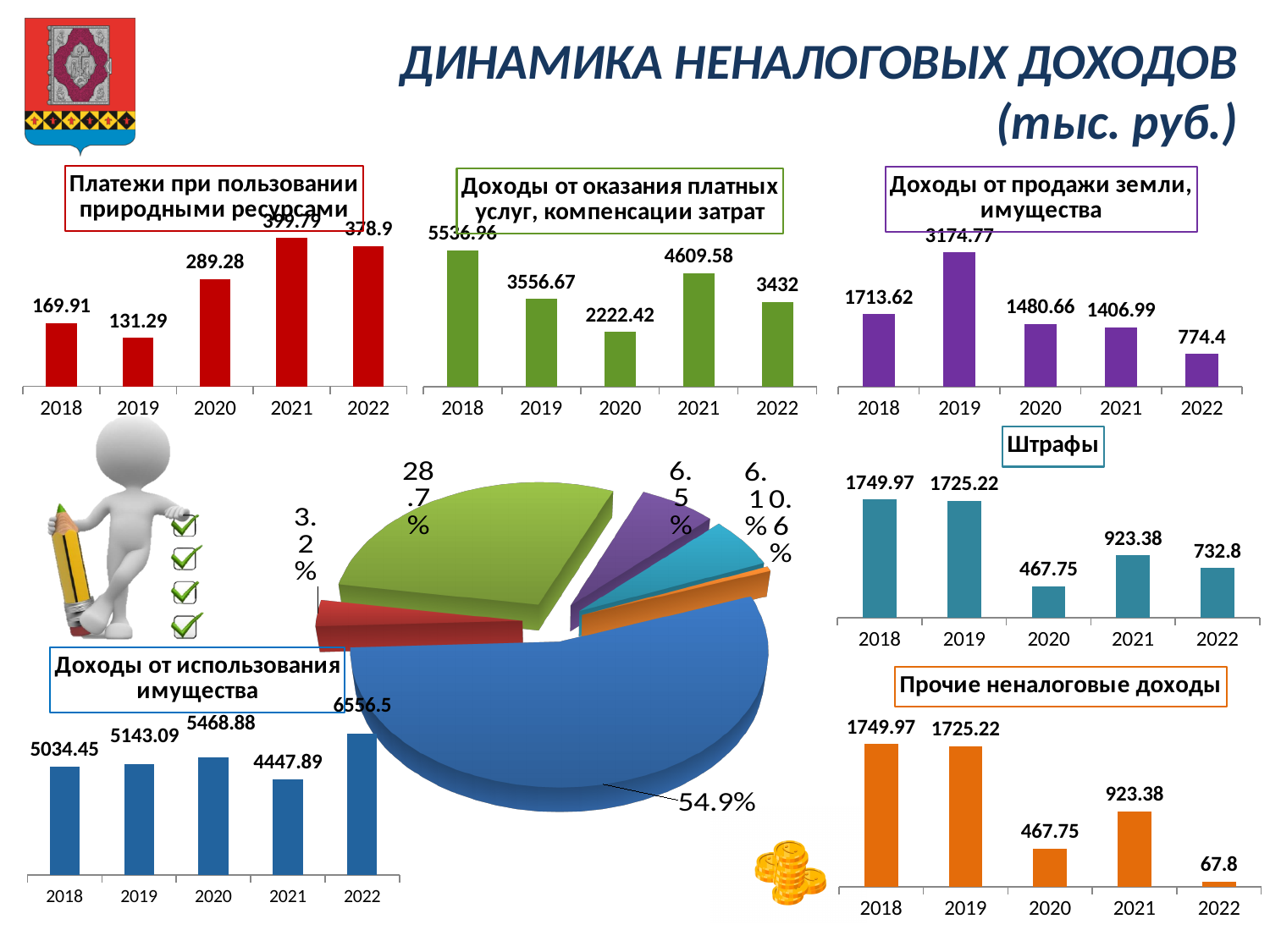
How many years are shown in the chart 'Штрафы'? 5 In the chart 'Доходы от использования имущества', what is the difference between the values for 2022 and 2021? 2108.61 In the chart 'Платежи при пользовании природными ресурсами', what is the value for 2020? 289.28 In the chart 'Доходы от оказания платных услуг, компенсации затрат', what is the value for 2021? 4609.58 In the chart 'Прочие неналоговые доходы', what is the value for 2022? 67.8 In the chart 'Доходы от продажи земли, имущества', what is the value for 2022? 774.4 In the chart 'Доходы от использования имущества', which year has the highest value? 2022 In the chart 'Доходы от оказания платных услуг, компенсации затрат', which year has the lowest value? 2020 In the chart 'Доходы от продажи земли, имущества', which year has the highest value? 2019 What kind of chart is the chart in the centre of the slide with the 54.9% slice? pie chart In the chart 'Штрафы', is the value for 2020 larger or smaller than the value for 2021? smaller In the chart 'Платежи при пользовании природными ресурсами', which year has the lowest value? 2019